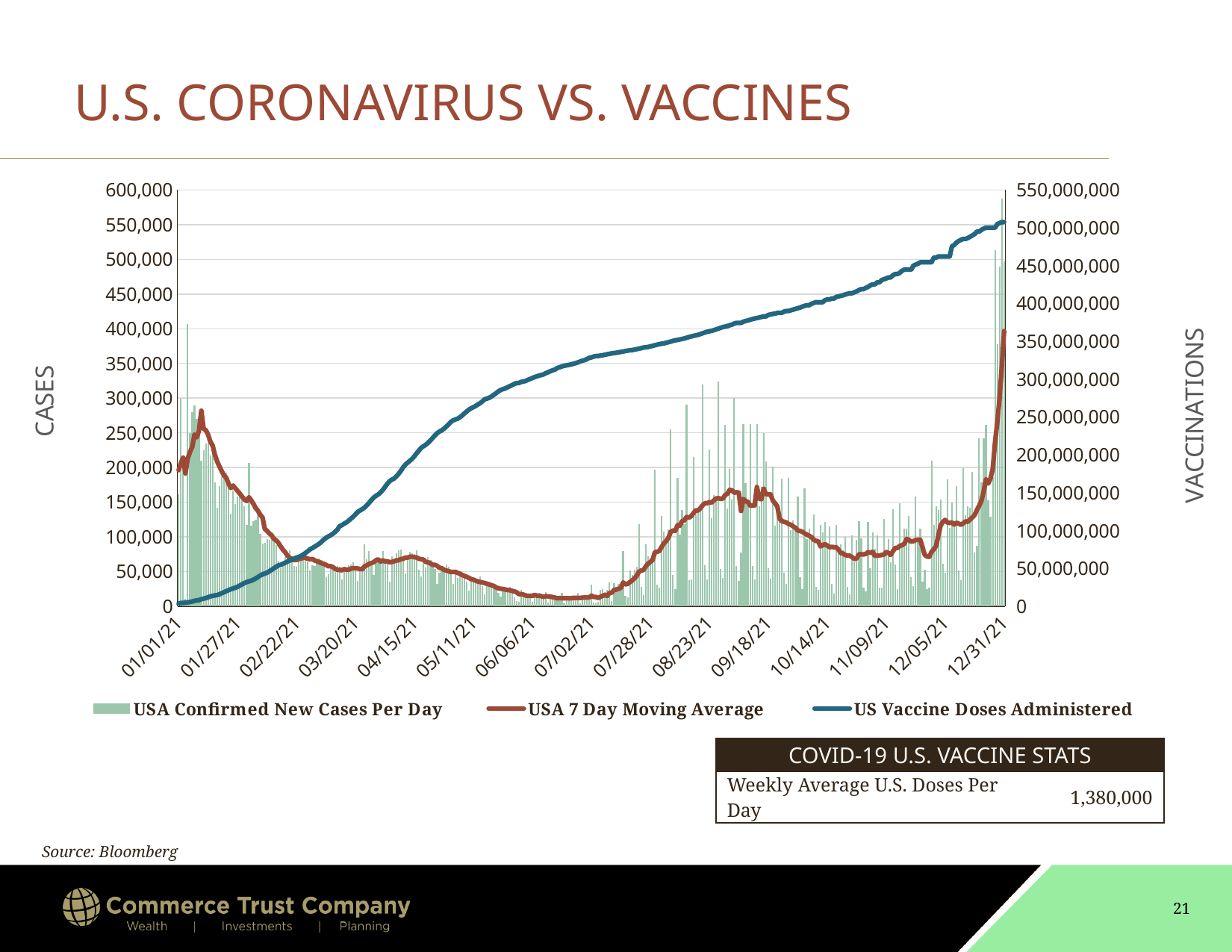
What is the Weekly Average U.S. Doses Per Day shown in the COVID-19 U.S. Vaccine Stats table? 1,380,000 Is the USA 7 Day Moving Average at 12/31/21 greater or less than 350,000? greater Which series is plotted as bars in the chart? USA Confirmed New Cases Per Day Does the US Vaccine Doses Administered line rise or fall from 01/01/21 to 12/31/21? Rise Does the USA 7 Day Moving Average rise or fall between 01/27/21 and 06/06/21? Fall Around which x-axis date does the tallest USA Confirmed New Cases Per Day bar occur? 12/31/21 Is the value of US Vaccine Doses Administered at 01/01/21 greater or less than 50,000,000? less Is the value of US Vaccine Doses Administered at 07/02/21 greater or less than 300,000,000? greater How many series does the chart legend list? 3 What kind of chart is shown on the slide? Combination bar and line chart What is the title of the chart on the slide? U.S. CORONAVIRUS VS. VACCINES